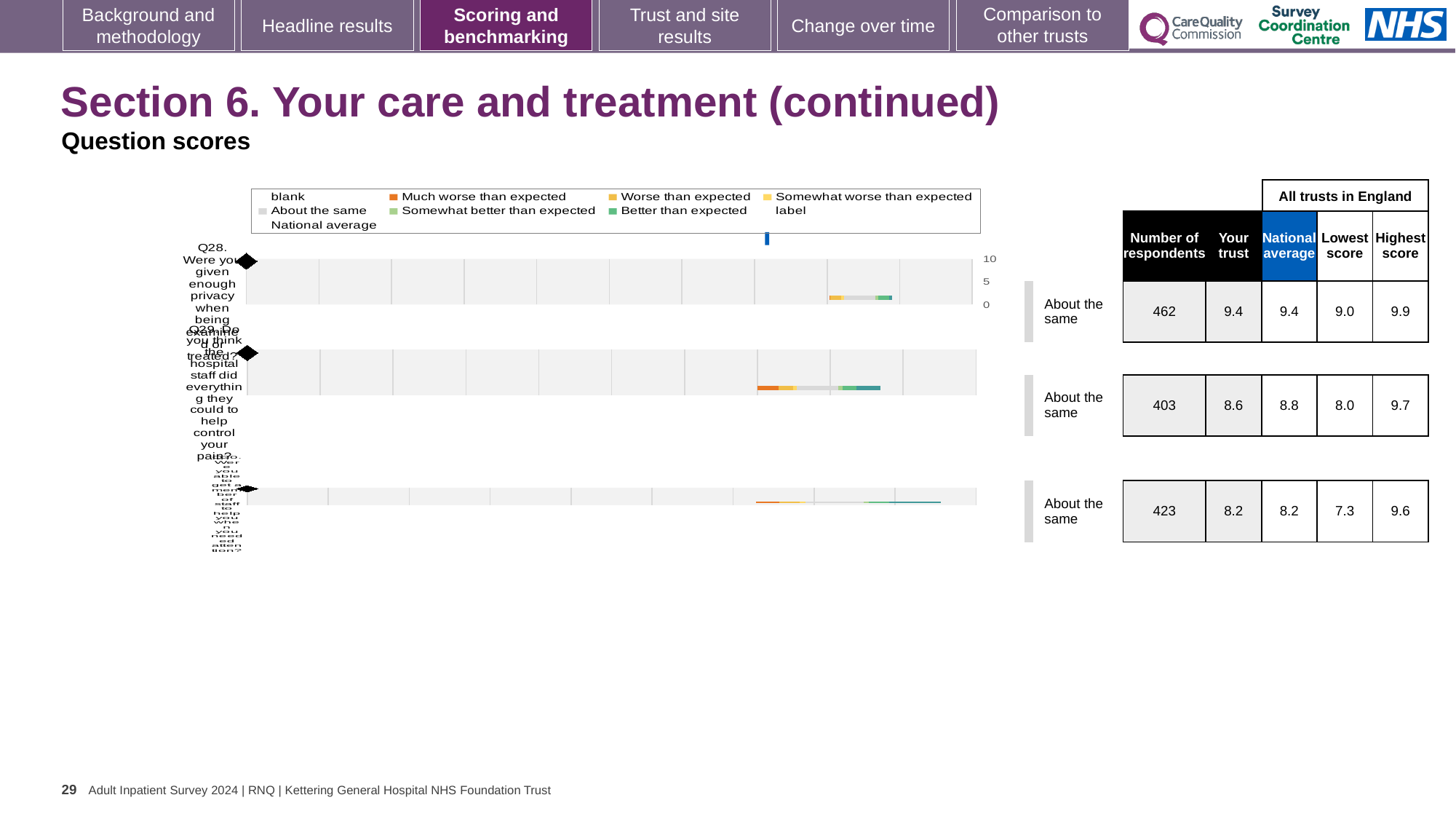
What kind of chart is used for the question scores on this slide? bar chart What is the 'Your trust' score for Q28 (Were you given enough privacy when being examined or treated?)? 9.4 Which question has the higher 'Your trust' score, Q28 or Q29? Q28 What is the maximum value shown on the score axis of the Q28 chart? 10 How many respondents answered Q28? 462 What benchmark category is shown for Q28? About the same What is the highest score among all trusts in England for Q29? 9.7 What is the national average score for Q29 (Do you think the hospital staff did everything they could to help control your pain?)? 8.8 What is the difference between the national average and the 'Your trust' score for Q29? 0.2 In the legend, what colour represents 'Much worse than expected'? orange Which of the three questions has the lowest 'Lowest score' across all trusts in England? Q30 How many questions (Q28, Q29, Q30) have a chart on this slide? 3